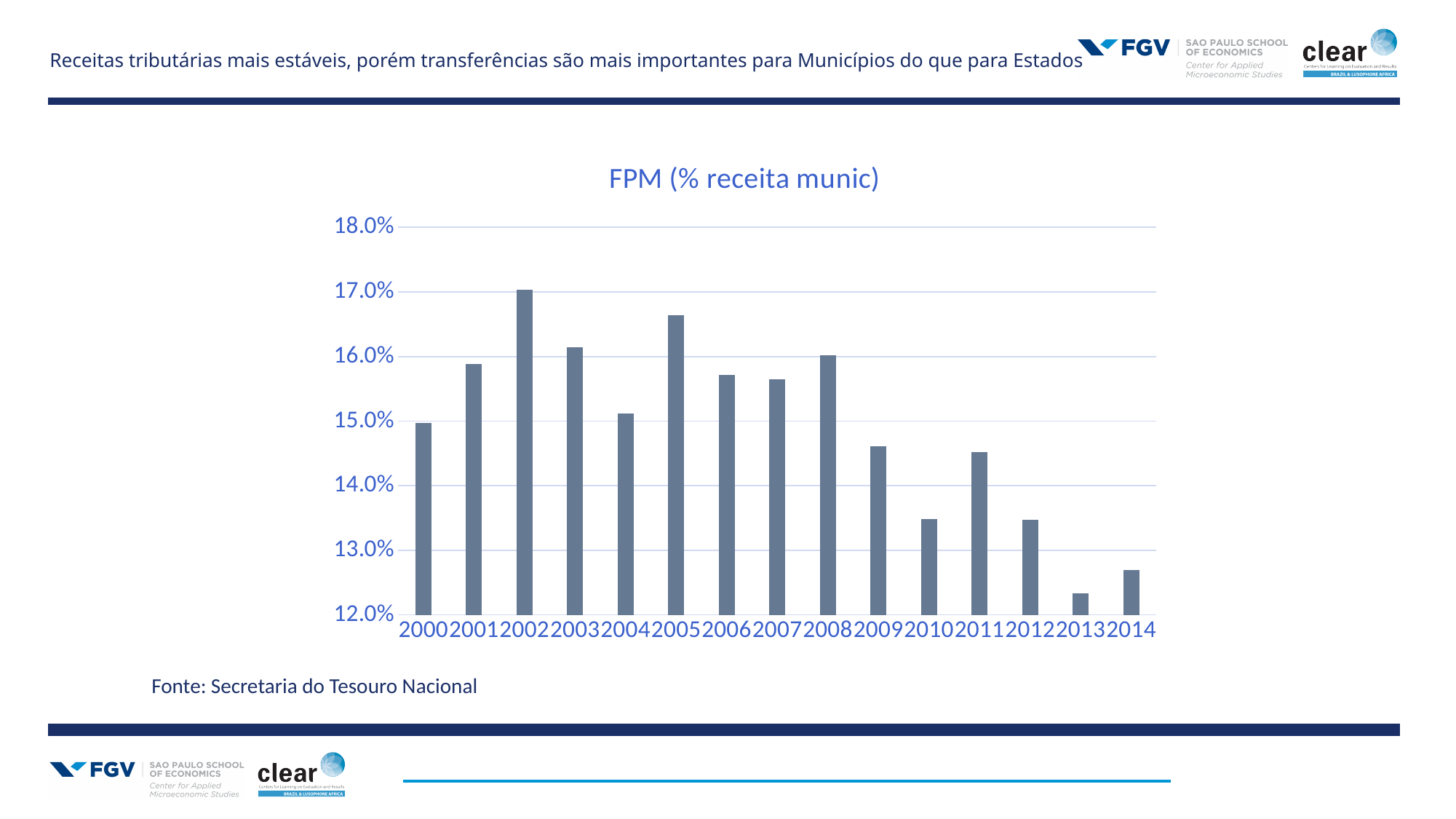
Which year has a larger FPM value, 2005 or 2009? 2005 Is the value for 2013 greater or less than 13.0%? less Which year has the highest FPM value? 2002 Is the value for 2002 greater or less than 16.0%? greater Overall, do the FPM values rise or fall from 2000 to 2014? fall Is the value for 2010 greater or less than 14.0%? less How many years are plotted on the x axis of the chart? 15 What is the title of the chart? FPM (% receita munic) Which year has a larger FPM value, 2013 or 2014? 2014 Which year has the lowest FPM value? 2013 What kind of chart is shown on the slide? bar chart